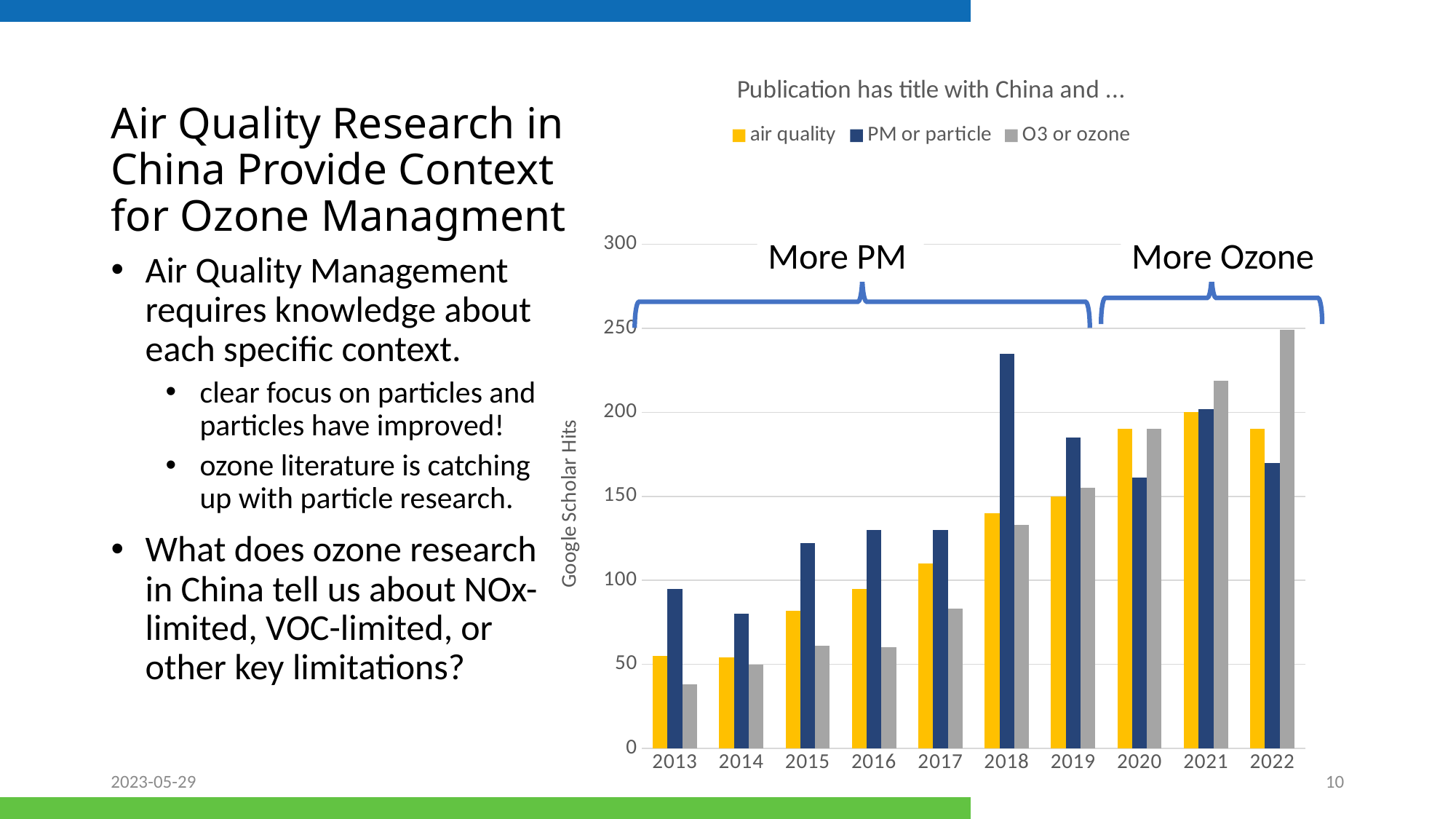
How many series does the chart legend list? 3 How many years are shown on the x axis of the chart? 10 Is the value for air quality in 2021 greater or less than 150? greater In which year is the O3 or ozone value lowest? 2013 In 2022, which is larger: the O3 or ozone value or the PM or particle value? O3 or ozone What kind of chart is shown on the slide? bar chart What is the title of the chart? Publication has title with China and … Do the O3 or ozone values generally rise or fall from 2013 to 2022? rise Is the value for O3 or ozone in 2013 greater or less than 50? less What is the label on the vertical axis of the chart? Google Scholar Hits In which year is the O3 or ozone value highest? 2022 Is the value for PM or particle in 2018 greater or less than 200? greater